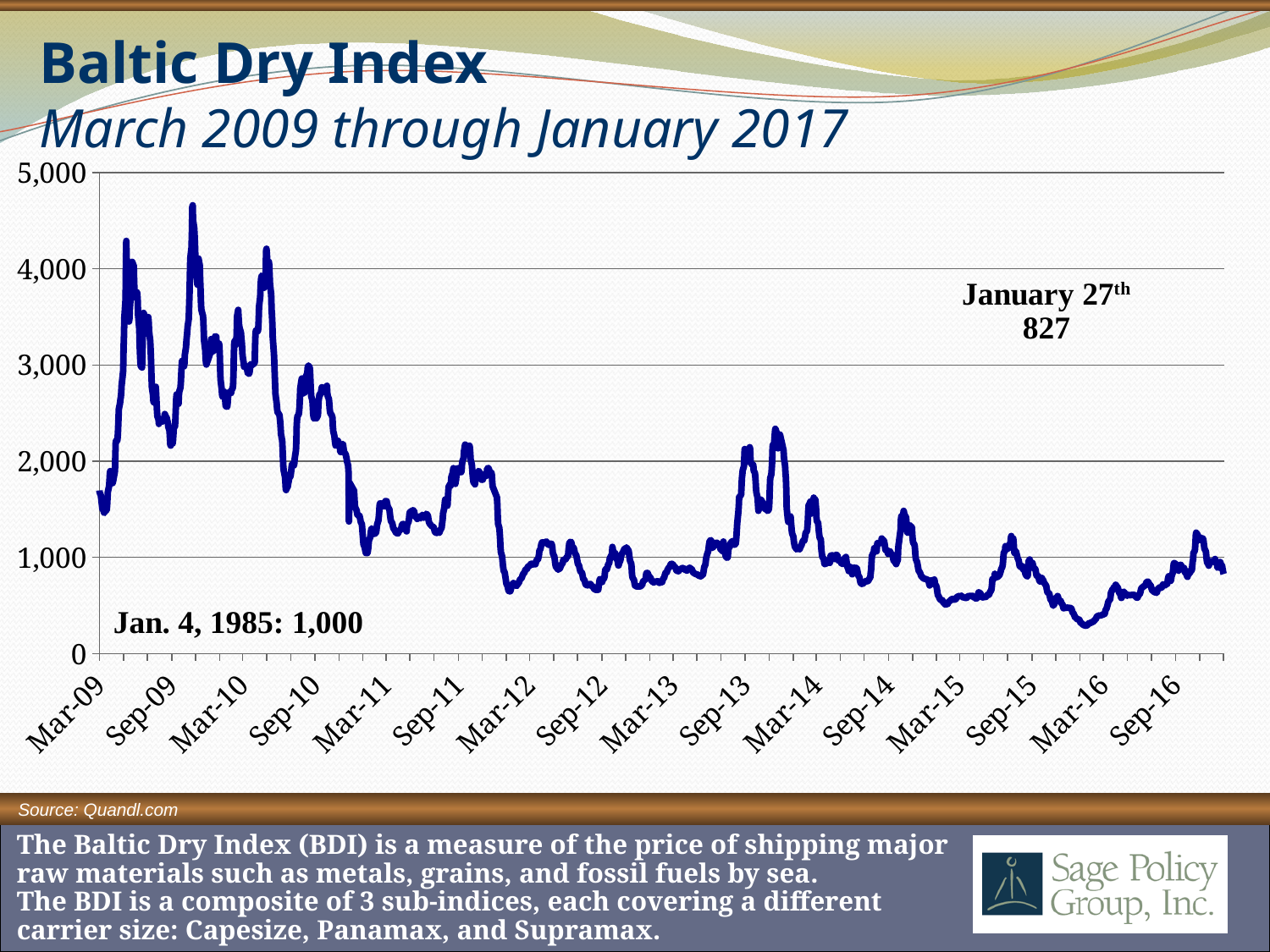
Is the peak of the index in late 2009 higher or lower than the peak in late 2013? higher Is the value of the index around Sep-13 greater or less than 1,000? greater Overall, does the index rise or fall from March 2009 to January 2017? fall What base value is noted on the chart for Jan. 4, 1985? 1,000 In which year does the index reach its lowest value on the chart? 2016 What kind of chart is shown on the slide? line chart Is the value of the index around Mar-16 greater or less than 1,000? less What is the value of the Baltic Dry Index on January 27th, as labelled on the chart? 827 What is the title of the chart? Baltic Dry Index, March 2009 through January 2017 Is the highest value reached by the index greater or less than 4,000? greater In which year does the index reach its highest value on the chart? 2009